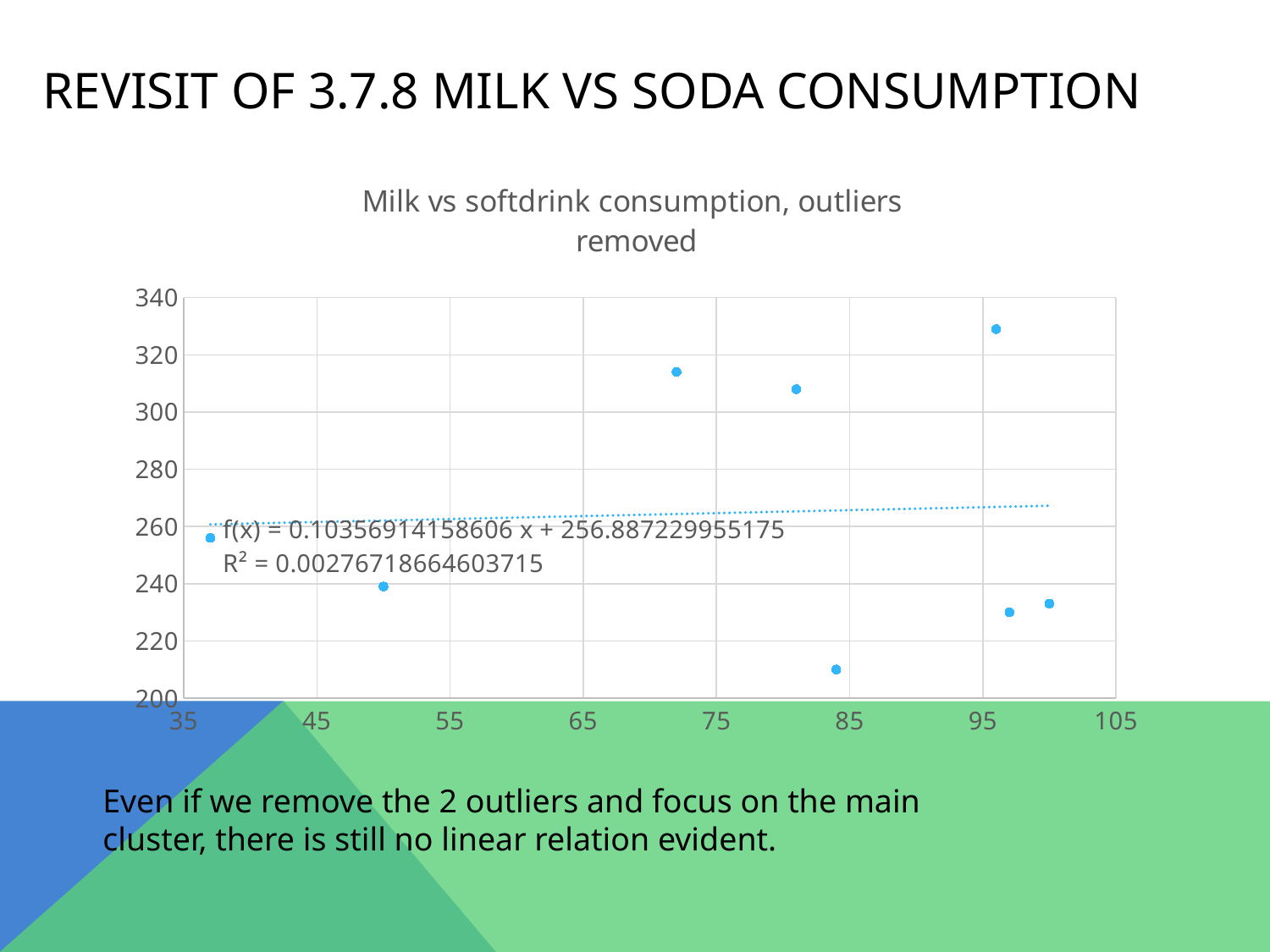
What R² value is printed on the chart? R² = 0.00276718664603715 Does the dotted trendline rise or fall as x increases? Rises slightly Is the y-value of the point near x = 72 greater or less than 300? greater Is the y-value of the point near x = 81 greater or less than 300? greater What is the title of the chart? Milk vs softdrink consumption, outliers removed Is the y-value of the point near x = 96 greater or less than 320? greater What kind of chart is shown on the slide? Scatter chart How many data points are plotted in the chart? 8 Which point has the highest y-value: the one near x = 72 or the one near x = 96? The one near x = 96 Which point has the lowest y-value: the one near x = 50 or the one near x = 84? The one near x = 84